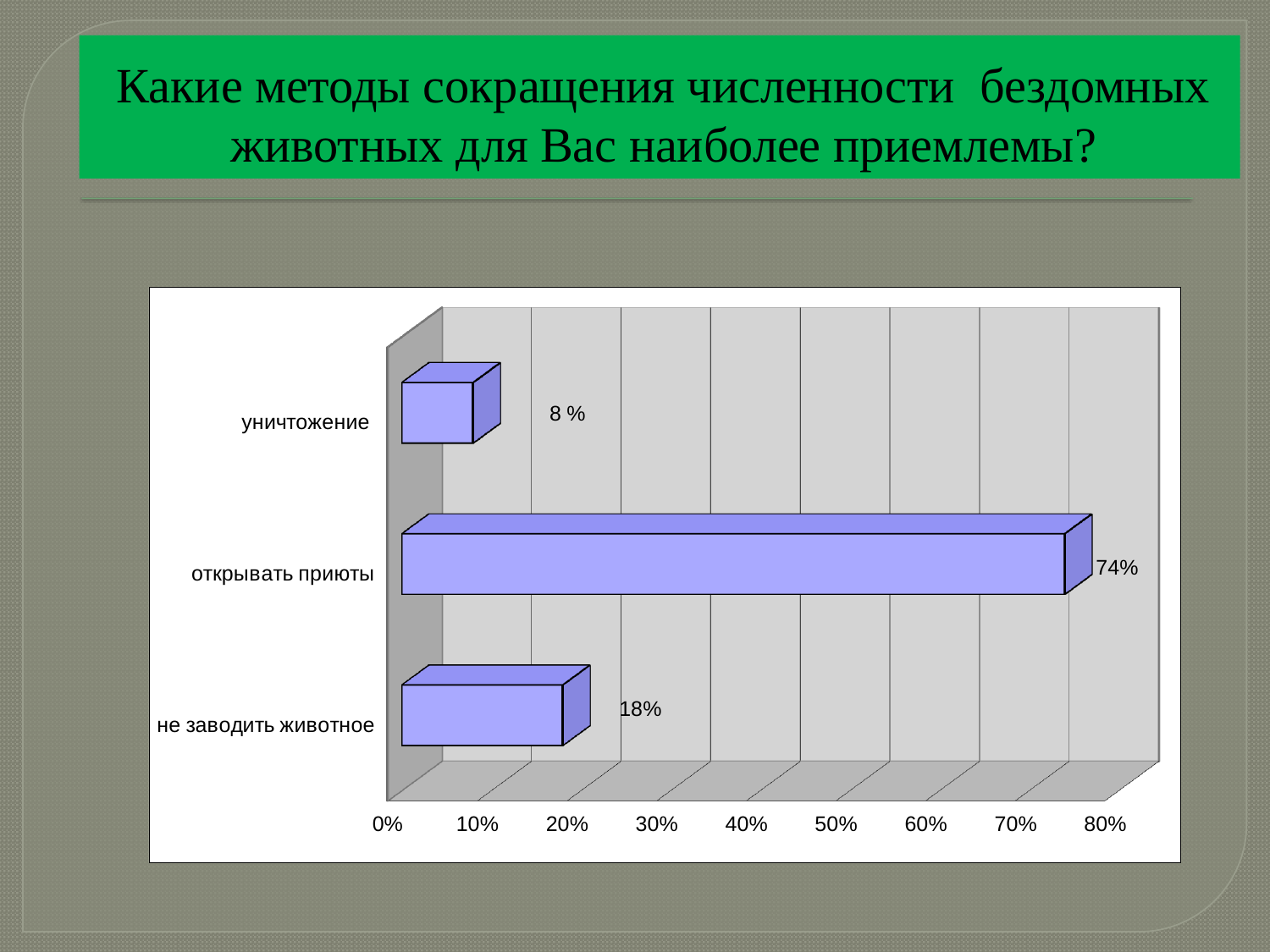
What kind of chart is shown on the slide? bar chart Which category has the lowest value? уничтожение What is the title of the slide above the chart? Какие методы сокращения численности бездомных животных для Вас наиболее приемлемы? Which is larger, the value for "не заводить животное" or the value for "уничтожение"? не заводить животное What is the value for "не заводить животное"? 18% What is the value for "уничтожение"? 8 % What is the difference between the values for "открывать приюты" and "не заводить животное"? 56% How many categories are shown in the chart? 3 What is the difference between the values for "не заводить животное" and "уничтожение"? 10% What is the value for "открывать приюты"? 74% Is the value for "открывать приюты" greater or less than 50%? greater Which category has the highest value? открывать приюты